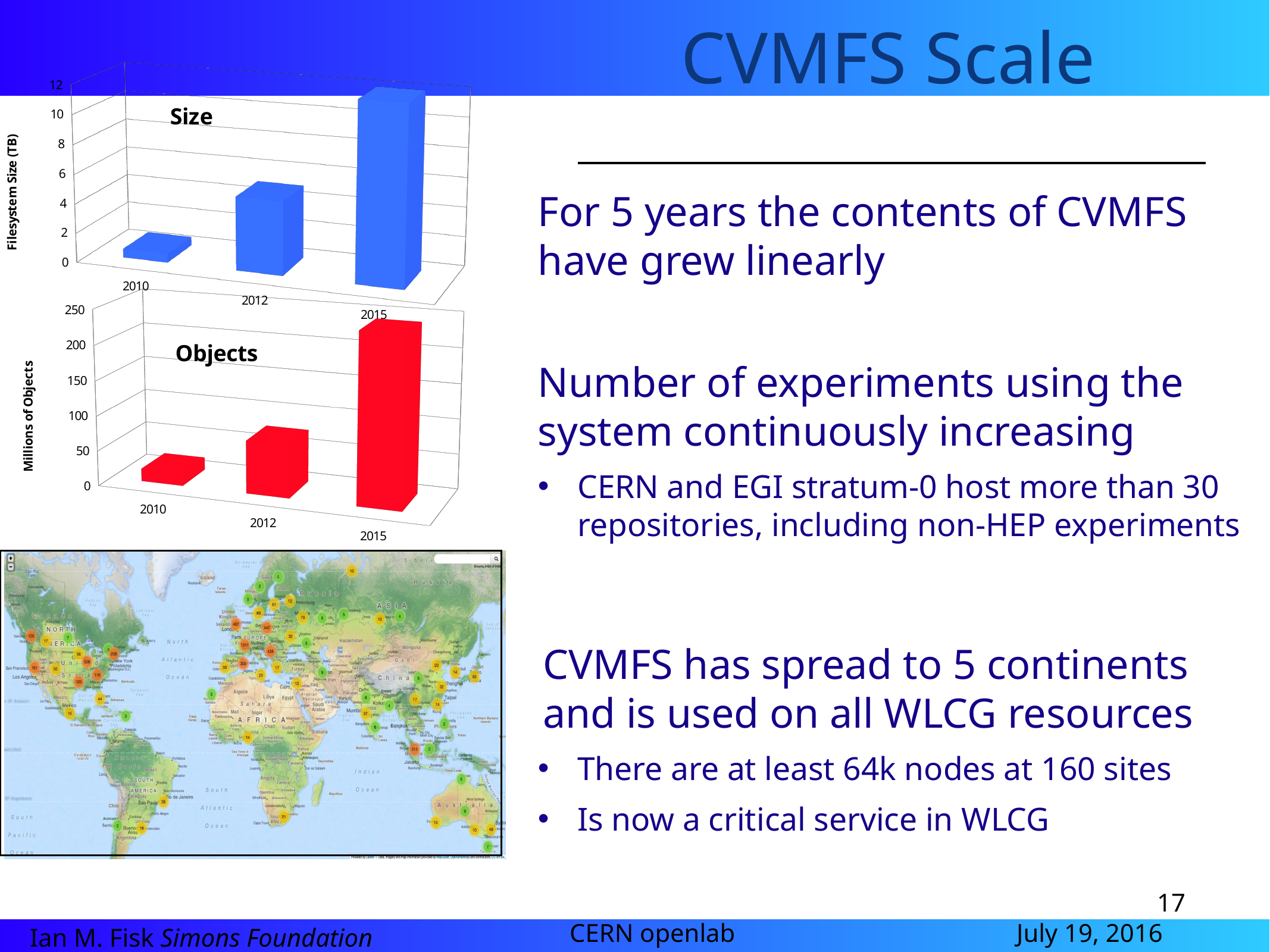
What is the y-axis label of the Size chart? Filesystem Size (TB) In the Objects chart, is the value for 2015 greater or less than 150? greater In the Objects chart, which year has the highest number of objects? 2015 How many years are shown in the Size chart? 3 In the Objects chart, which is larger, the value for 2012 or the value for 2015? 2015 In the Size chart, is the value for 2015 greater or less than 8? greater In the Objects chart, which year has the lowest number of objects? 2010 In the Size chart, which year has the highest filesystem size? 2015 In the Size chart, is the value for 2010 greater or less than 2? less In the Size chart, which year has the lowest filesystem size? 2010 What kind of chart is the Objects chart? bar chart